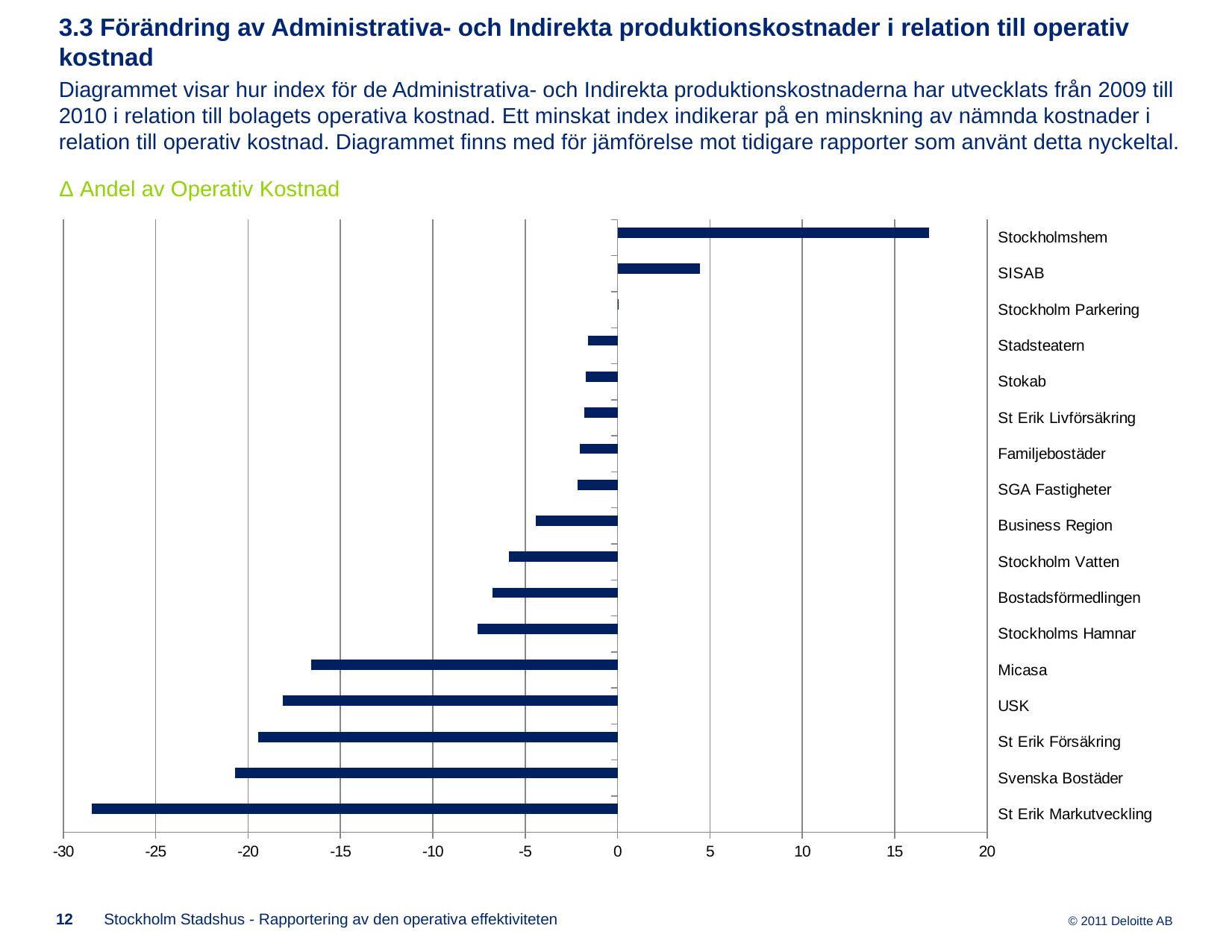
Is the value for St Erik Markutveckling greater or less than -25? less Is the value for SISAB greater or less than 5? less Which has the larger value, Stockholm Vatten or Business Region? Business Region Is the value for Stockholms Hamnar greater or less than -10? greater What is the title shown above the chart? Δ Andel av Operativ Kostnad Which company has the lowest value in the chart? St Erik Markutveckling Which has the larger value, Svenska Bostäder or USK? USK Which company has the highest value in the chart? Stockholmshem What kind of chart is shown on the slide? bar chart How many companies (categories) are plotted in the chart? 17